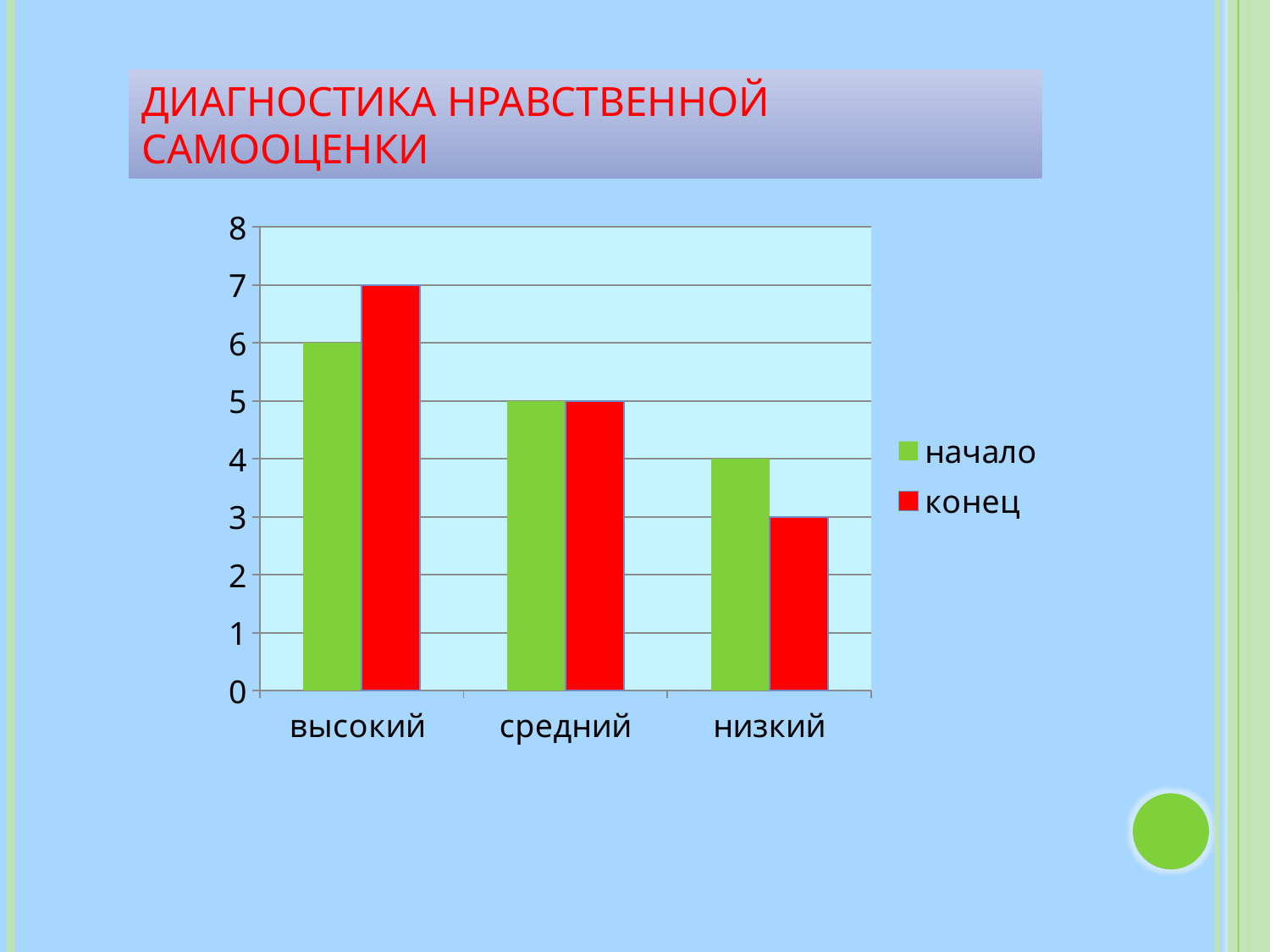
Which colour represents the конец series in the legend? red Which category has the highest value for the конец series? высокий Which category has the lowest value for the начало series? низкий How many categories are shown on the x axis? 3 What is the value for начало in the высокий category? 6 What is the value for конец in the высокий category? 7 What is the value for конец in the низкий category? 3 How many series does the legend list? 2 What is the value for начало in the низкий category? 4 What kind of chart is shown on the slide? bar chart What is the difference between the конец and начало values in the высокий category? 1 In the низкий category, which is larger: начало or конец? начало